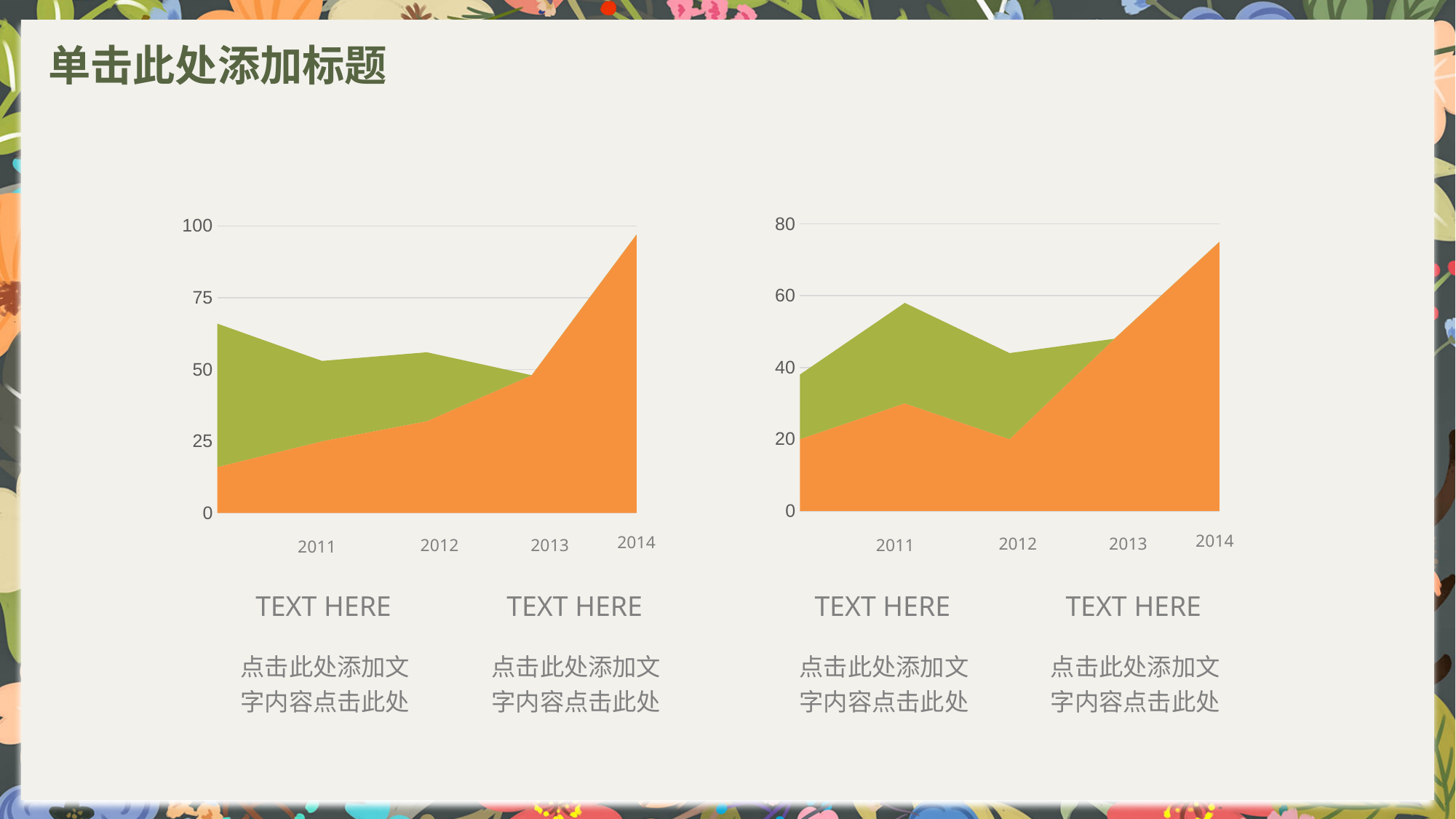
In the left chart, does the orange series rise or fall from 2011 to 2014? rise In the right chart, which year has the lowest value for the orange series? 2012 In the right chart, how many years are shown on the x axis? 4 What kind of chart is the chart on the left of the slide? area chart What kind of chart is the chart on the right of the slide? area chart In the left chart, which year has the highest value for the orange series? 2014 In the right chart, is the value of the orange series for 2014 greater or less than 60? greater In the right chart, is the value of the orange series for 2012 greater or less than 40? less In the right chart, does the orange series rise or fall from 2011 to 2014? rise In the left chart, is the value of the orange series for 2014 greater or less than 75? greater In the left chart, how many years are shown on the x axis? 4